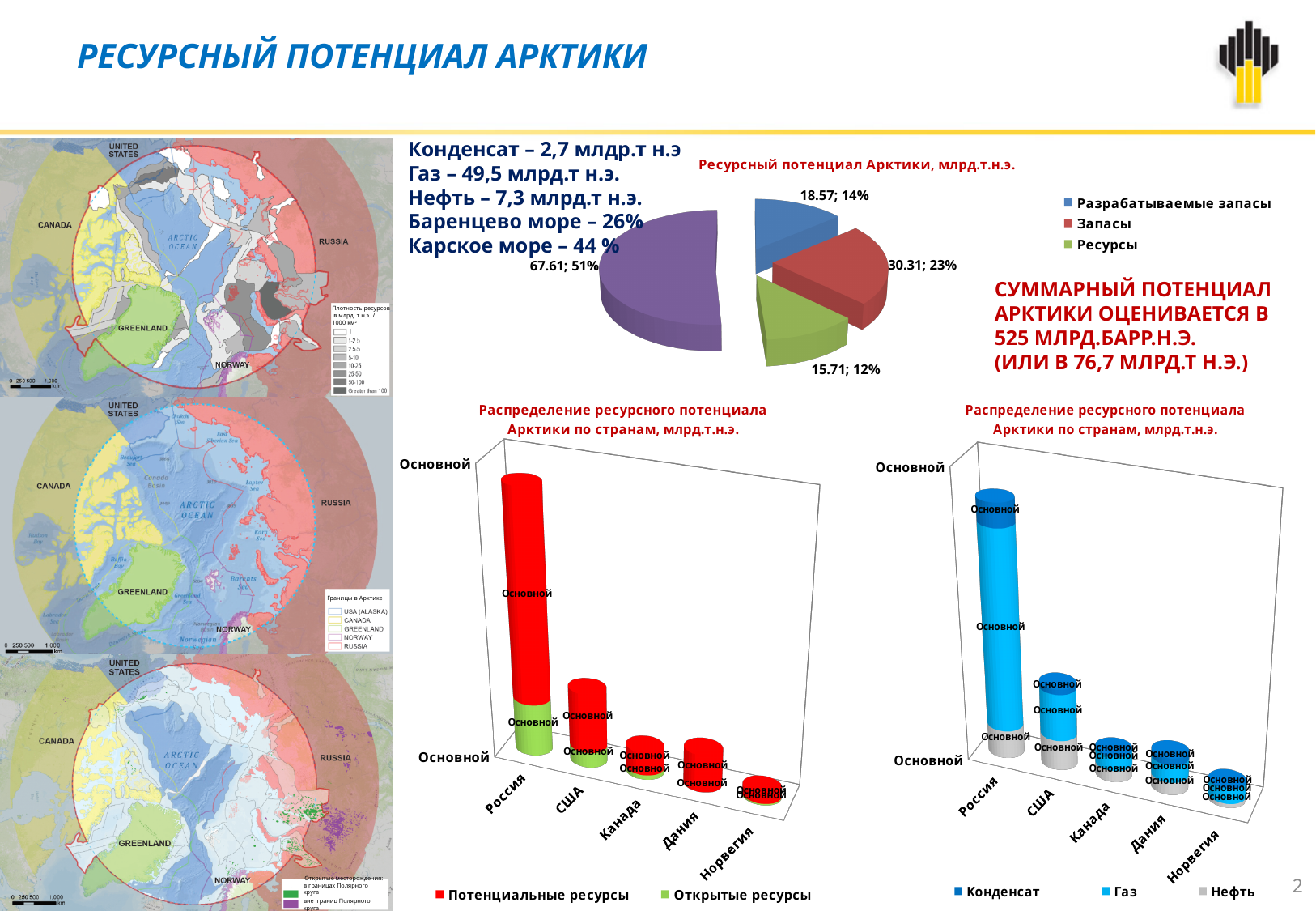
What series does the legend of the right bar chart 'Распределение ресурсного потенциала Арктики по странам' list? Конденсат, Газ, Нефть How many countries are shown on the x axis of the right bar chart 'Распределение ресурсного потенциала Арктики по странам'? 5 In the pie chart 'Ресурсный потенциал Арктики, млрд.т.н.э.', what share of the pie does the largest slice have? 51% In the pie chart 'Ресурсный потенциал Арктики, млрд.т.н.э.', what value is shown for Ресурсы? 15.71; 12% How many entries does the legend of the pie chart 'Ресурсный потенциал Арктики, млрд.т.н.э.' list? 3 What kind of chart is the left chart titled 'Распределение ресурсного потенциала Арктики по странам, млрд.т.н.э.'? Bar chart How many slices does the pie chart 'Ресурсный потенциал Арктики, млрд.т.н.э.' have? 4 In the left bar chart 'Распределение ресурсного потенциала Арктики по странам', which country has the highest bar? Россия In the pie chart 'Ресурсный потенциал Арктики, млрд.т.н.э.', what value is shown for Запасы? 30.31; 23% In the pie chart 'Ресурсный потенциал Арктики, млрд.т.н.э.', what value is shown for Разрабатываемые запасы? 18.57; 14% In the pie chart 'Ресурсный потенциал Арктики, млрд.т.н.э.', what is the difference between the values for Запасы and Разрабатываемые запасы? 11.74 In the pie chart 'Ресурсный потенциал Арктики, млрд.т.н.э.', which is larger, Запасы or Ресурсы? Запасы